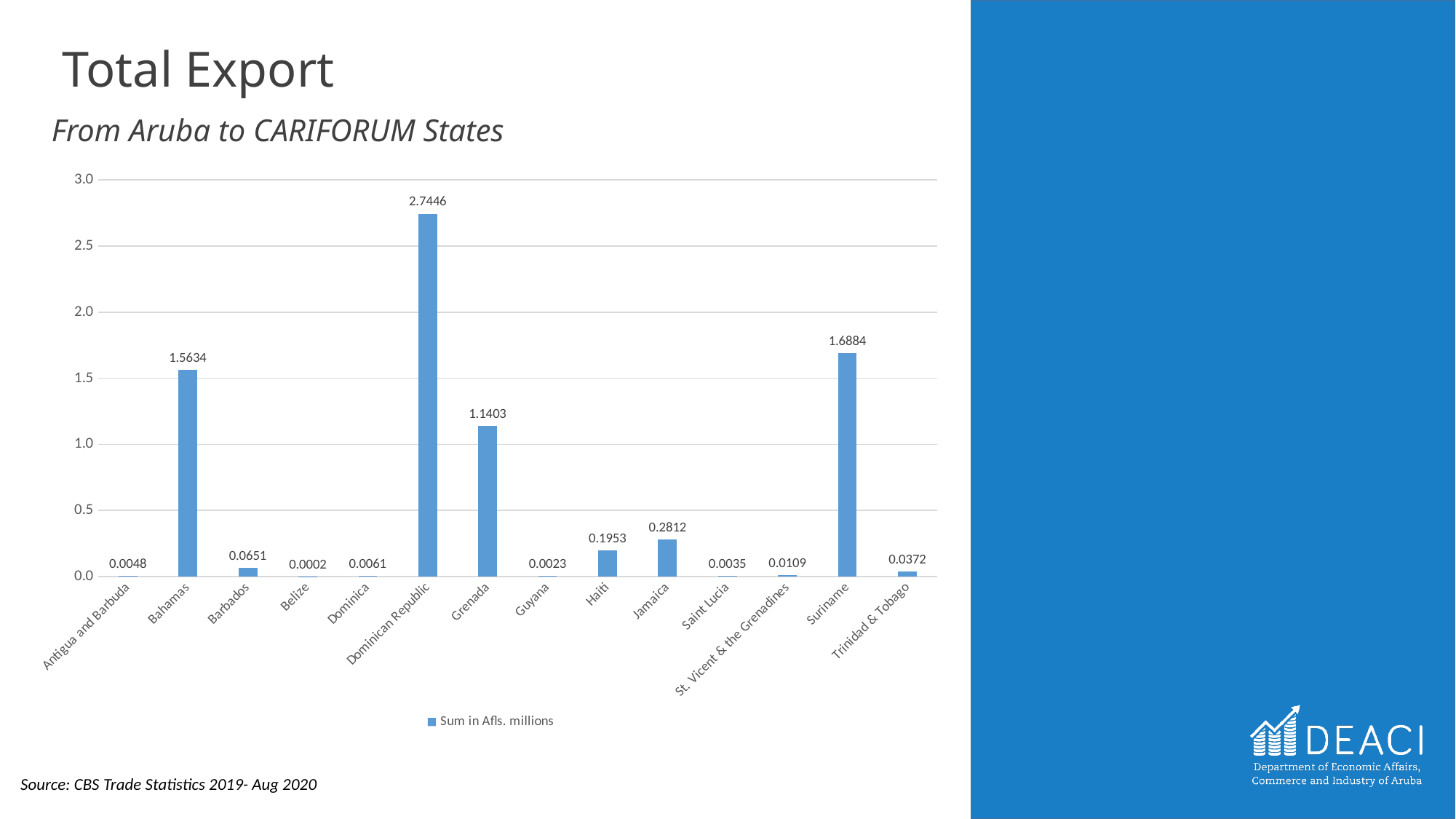
What is the difference between the values for Jamaica and Haiti? 0.0859 What is the value for Dominican Republic? 2.7446 What is the legend entry for the series shown in the chart? Sum in Afls. millions What is the difference between the values for Dominican Republic and Suriname? 1.0562 Which CARIFORUM state has the lowest export value? Belize What is the value for Suriname? 1.6884 Which CARIFORUM state has the highest export value? Dominican Republic How many CARIFORUM states are shown on the x axis? 14 What kind of chart is shown on the slide? Bar chart Which is larger, the value for Suriname or the value for Bahamas? Suriname What is the value for Jamaica? 0.2812 What is the value for Trinidad & Tobago? 0.0372